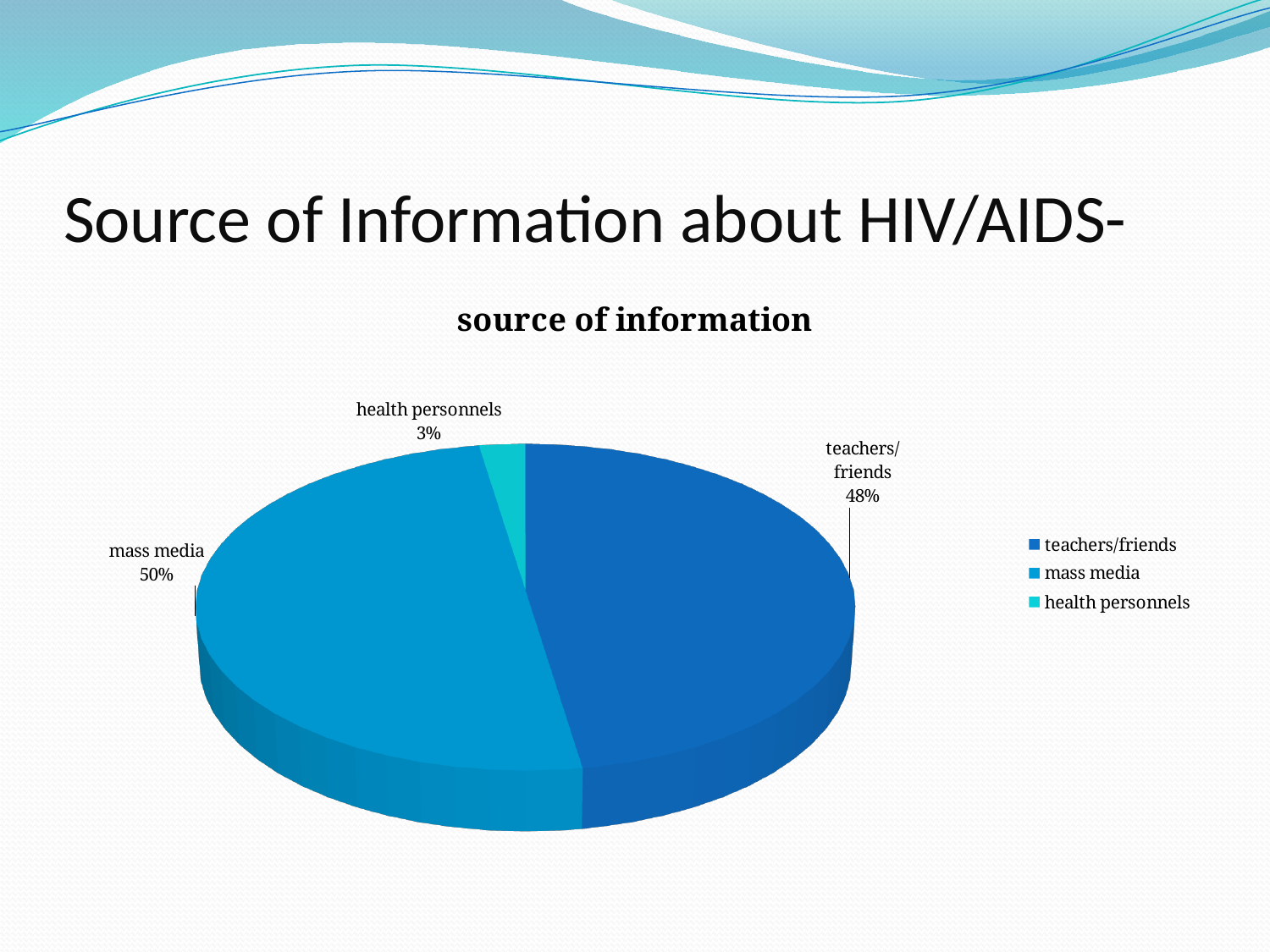
How many categories are shown in the pie chart? 3 What share of the pie does health personnels account for? 3% What is the difference in percentage points between teachers/friends and health personnels? 45% Which source of information has the smallest share? health personnels What kind of chart is shown on the slide? pie chart What share of the pie does teachers/friends account for? 48% How many entries does the legend list? 3 What share of the pie does mass media account for? 50% What is the difference in percentage points between mass media and teachers/friends? 2% Which source of information has the largest share? mass media What is the title of the chart? source of information Which is larger, the share for teachers/friends or the share for health personnels? teachers/friends